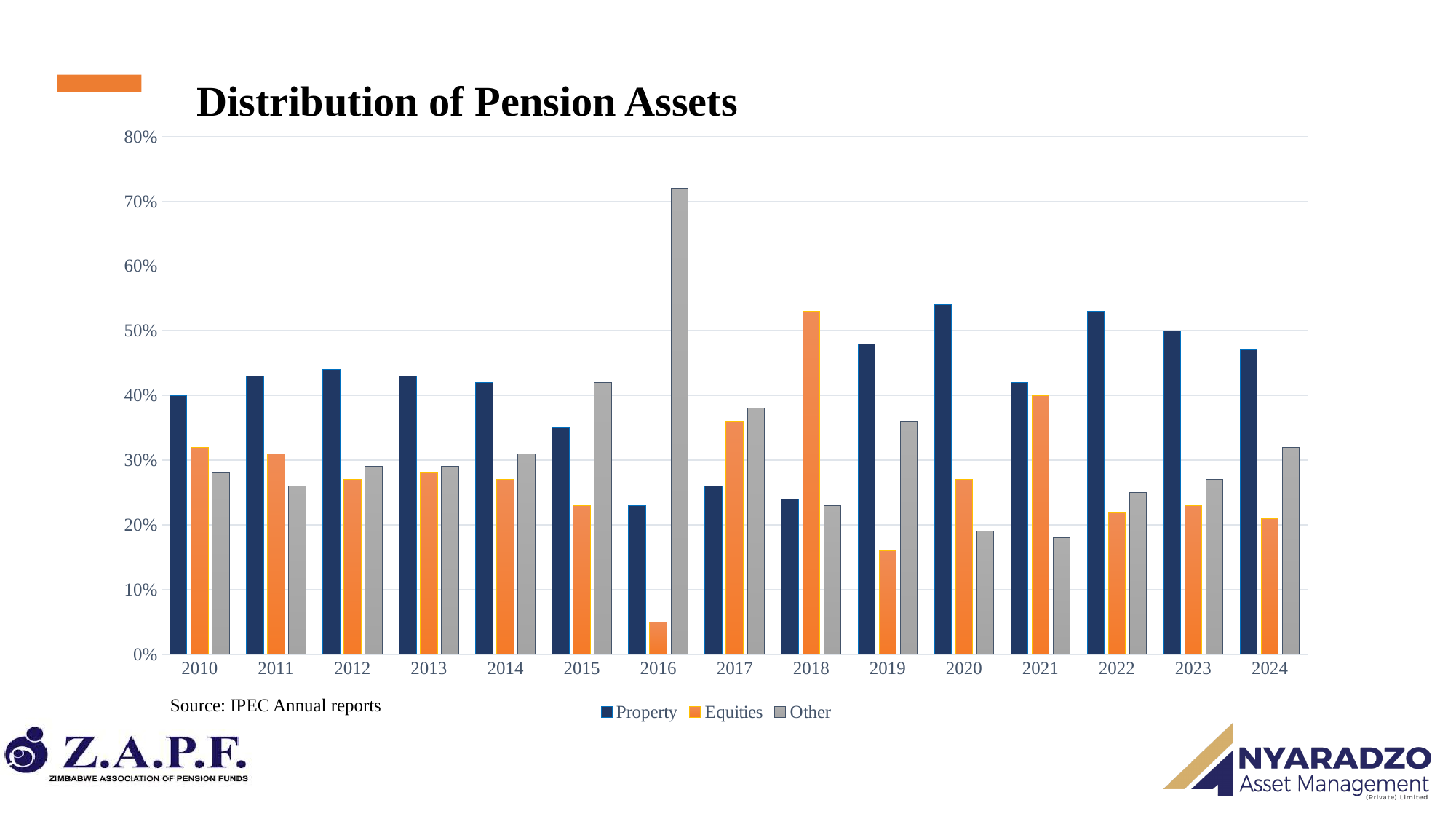
How many series does the legend list? 3 In 2019, which is larger, Property or Equities? Property Which series is shown in orange? Equities In which year is the Equities series at its highest? 2018 What kind of chart is shown on the slide? bar chart Is the value for Equities in 2016 greater or less than 10%? less How many years are shown along the x axis? 15 Is the value for Property in 2018 greater or less than 30%? less Is the value for Other in 2016 greater or less than 70%? greater In which year is the Other series at its highest? 2016 What is the title of the chart? Distribution of Pension Assets In which year is the Equities series at its lowest? 2016